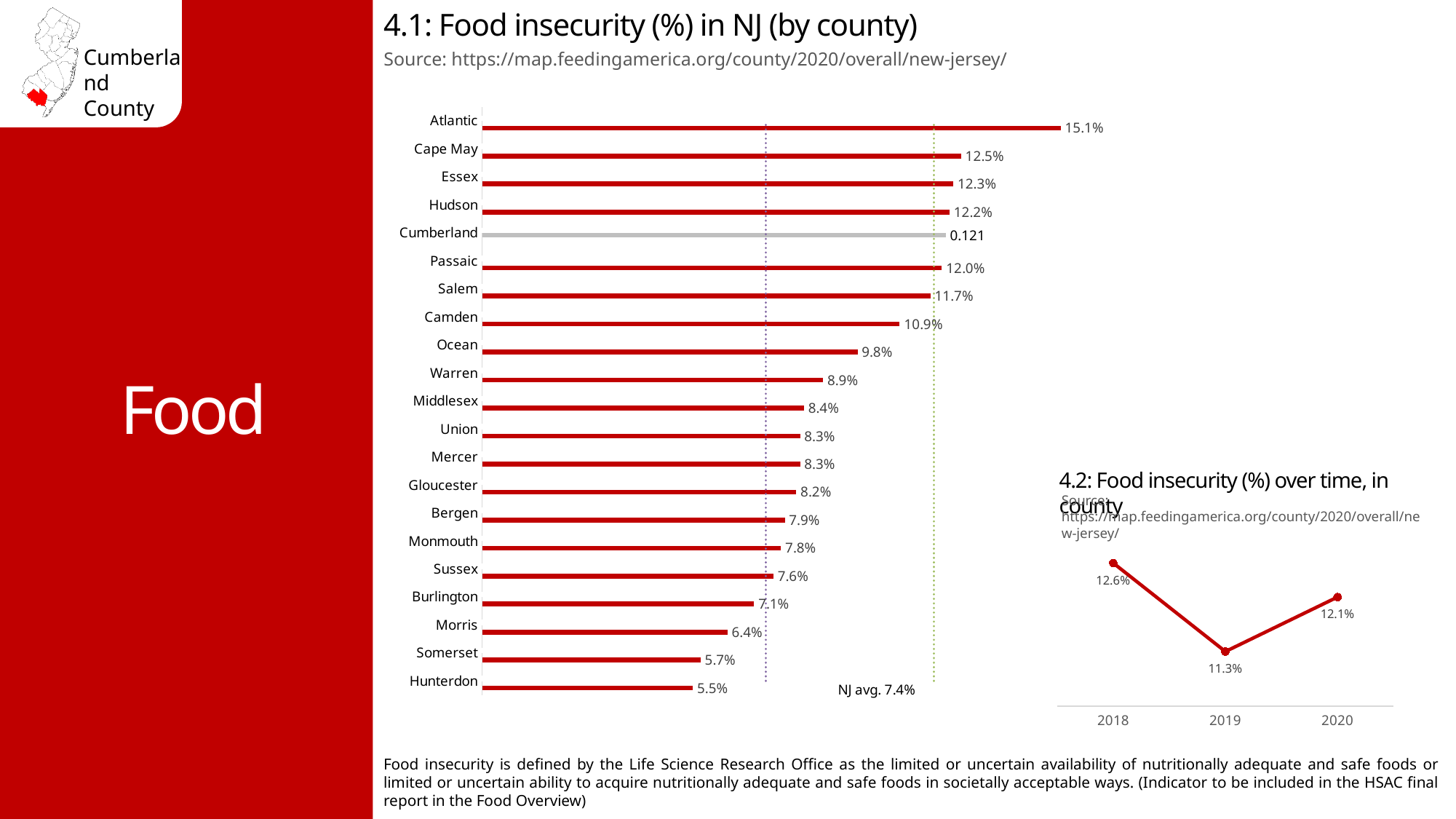
In chart 4.1 (Food insecurity by county), how many counties are plotted? 21 In chart 4.2 (Food insecurity over time), what is the difference between 2018 and 2019? 1.3% In chart 4.2 (Food insecurity over time), what is the value for 2019? 11.3% In chart 4.1 (Food insecurity by county), what is the difference between Atlantic and Hunterdon? 9.6% In chart 4.1 (Food insecurity by county), what is the value for Atlantic? 15.1% In chart 4.1 (Food insecurity by county), which county has the lowest value? Hunterdon In chart 4.1 (Food insecurity by county), what is the value for Camden? 10.9% In chart 4.2 (Food insecurity over time), what kind of chart is shown? line chart In chart 4.1 (Food insecurity by county), which is larger, Ocean or Warren? Ocean In chart 4.1 (Food insecurity by county), what is the data label shown for Cumberland? 0.121 In chart 4.1 (Food insecurity by county), which county has the highest value? Atlantic In chart 4.1 (Food insecurity by county), what NJ average is noted on the chart? 7.4%